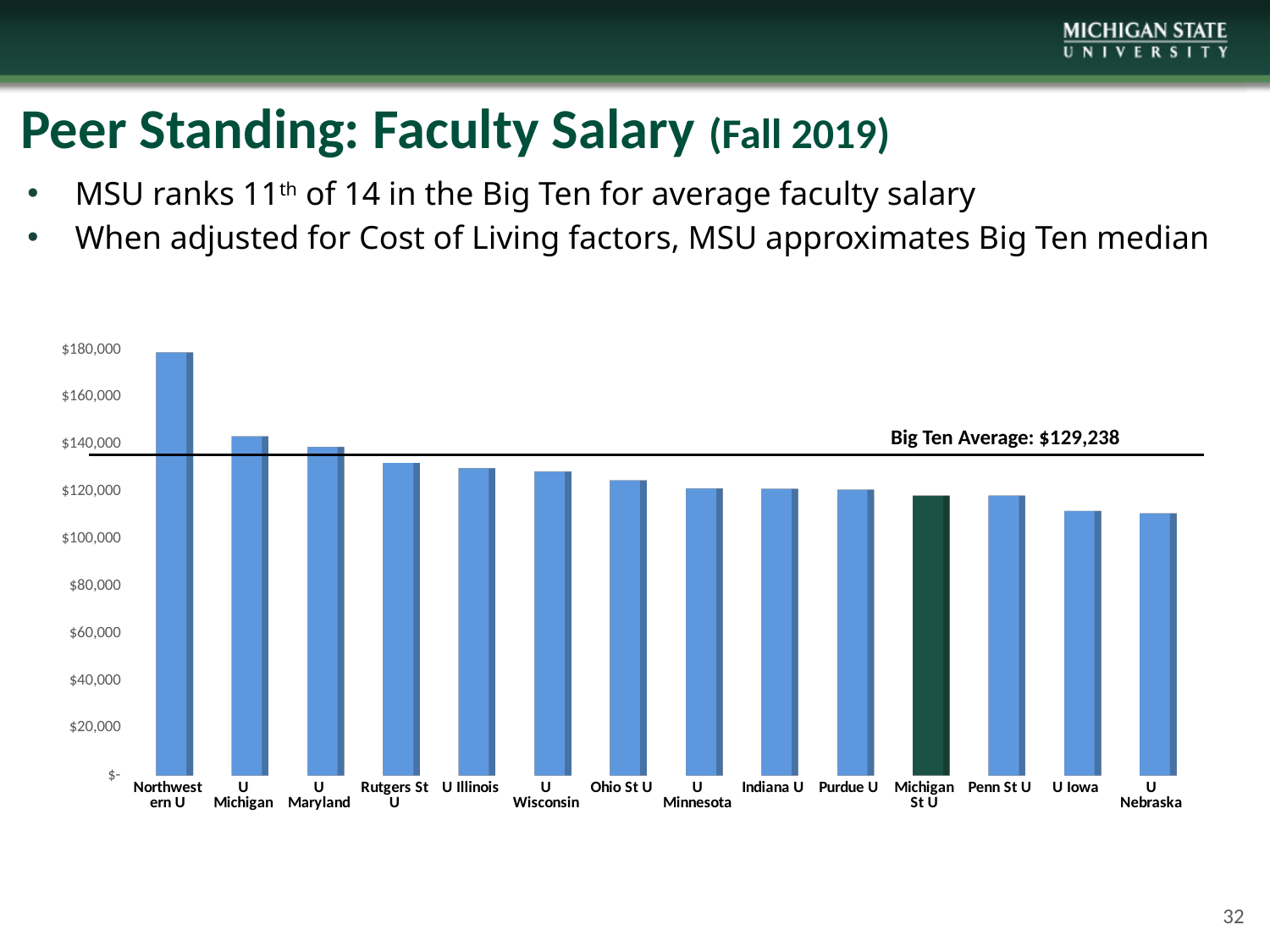
Is the value for Michigan St U greater or less than $140,000? less Is the value for Rutgers St U greater or less than $120,000? greater How many universities are shown as bars in the chart? 14 Is the value for Northwestern U greater or less than $160,000? greater Which university's bar is shown in a different (dark green) colour from the others? Michigan St U Do the bar values rise or fall from left to right across the chart? fall What kind of chart is shown on the slide? bar chart Which has a higher average faculty salary, U Maryland or U Iowa? U Maryland Which university has the lowest average faculty salary in the chart? U Nebraska What is the Big Ten Average faculty salary shown on the chart? $129,238 Which university has the highest average faculty salary in the chart? Northwestern U